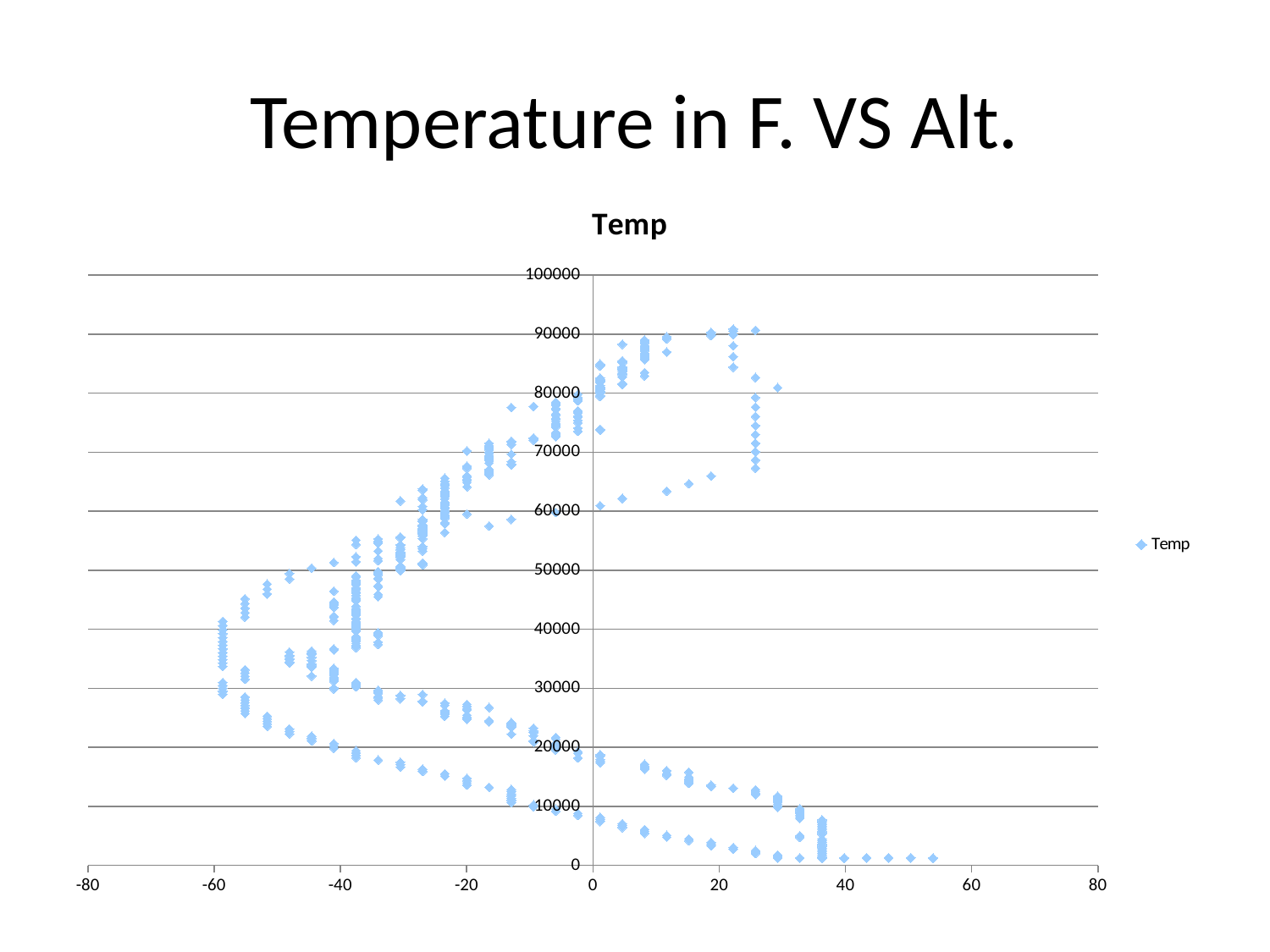
What kind of chart is shown on the slide? scatter chart What is the name of the series shown in the legend? Temp Is the highest altitude plotted on the chart greater or less than 100000? less Is the highest temperature value plotted on the chart greater or less than 40? greater Is the highest temperature value plotted on the chart greater or less than 60? less What is the title printed above the chart? Temp Between altitudes of 0 and 10000, do the plotted temperatures generally rise or fall as altitude increases? fall How many series does the legend list? 1